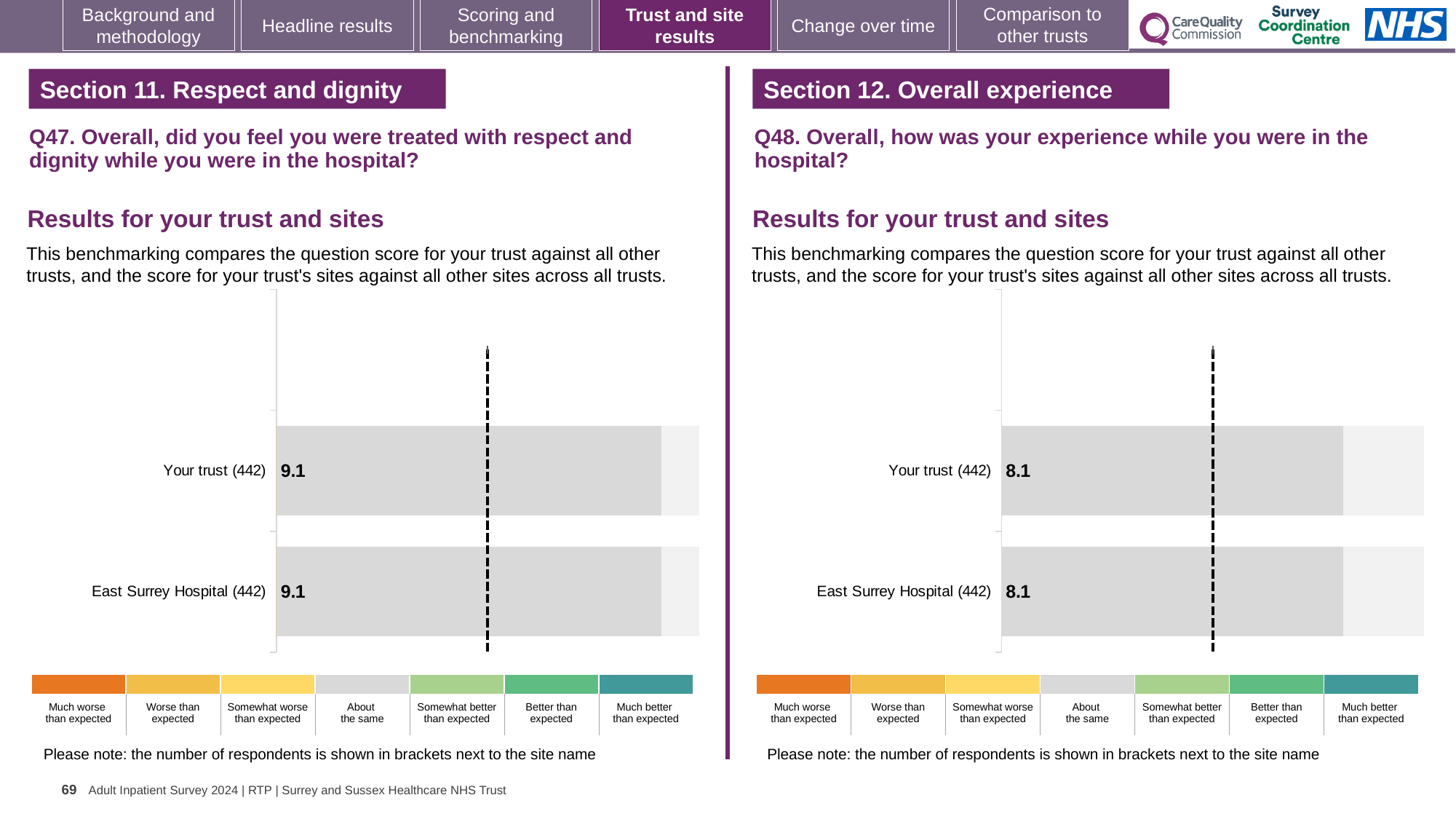
On the right chart (Q48), how many respondents are shown in brackets next to East Surrey Hospital? 442 On the left chart (Q47), how many bars are plotted? 2 What kind of chart is used on the left (Q47) to show the results for your trust and sites? Bar chart On the right chart (Q48), how many bars are plotted? 2 On the left chart (Q47, Section 11. Respect and dignity), what is the score for Your trust (442)? 9.1 On the right chart (Q48, Section 12. Overall experience), what is the score for Your trust (442)? 8.1 On the left chart (Q47), which benchmarking category does the grey colour of the bars correspond to in the legend below the chart? About the same On the right chart (Q48), what is the difference between the score for Your trust and the score for East Surrey Hospital? 0.0 On the left chart (Q47), what is the difference between the score for Your trust and the score for East Surrey Hospital? 0.0 On the right chart (Q48, Section 12. Overall experience), what is the score for East Surrey Hospital (442)? 8.1 On the left chart (Q47, Section 11. Respect and dignity), what is the score for East Surrey Hospital (442)? 9.1 What is the difference between the Your trust score on the left chart (Q47) and the Your trust score on the right chart (Q48)? 1.0